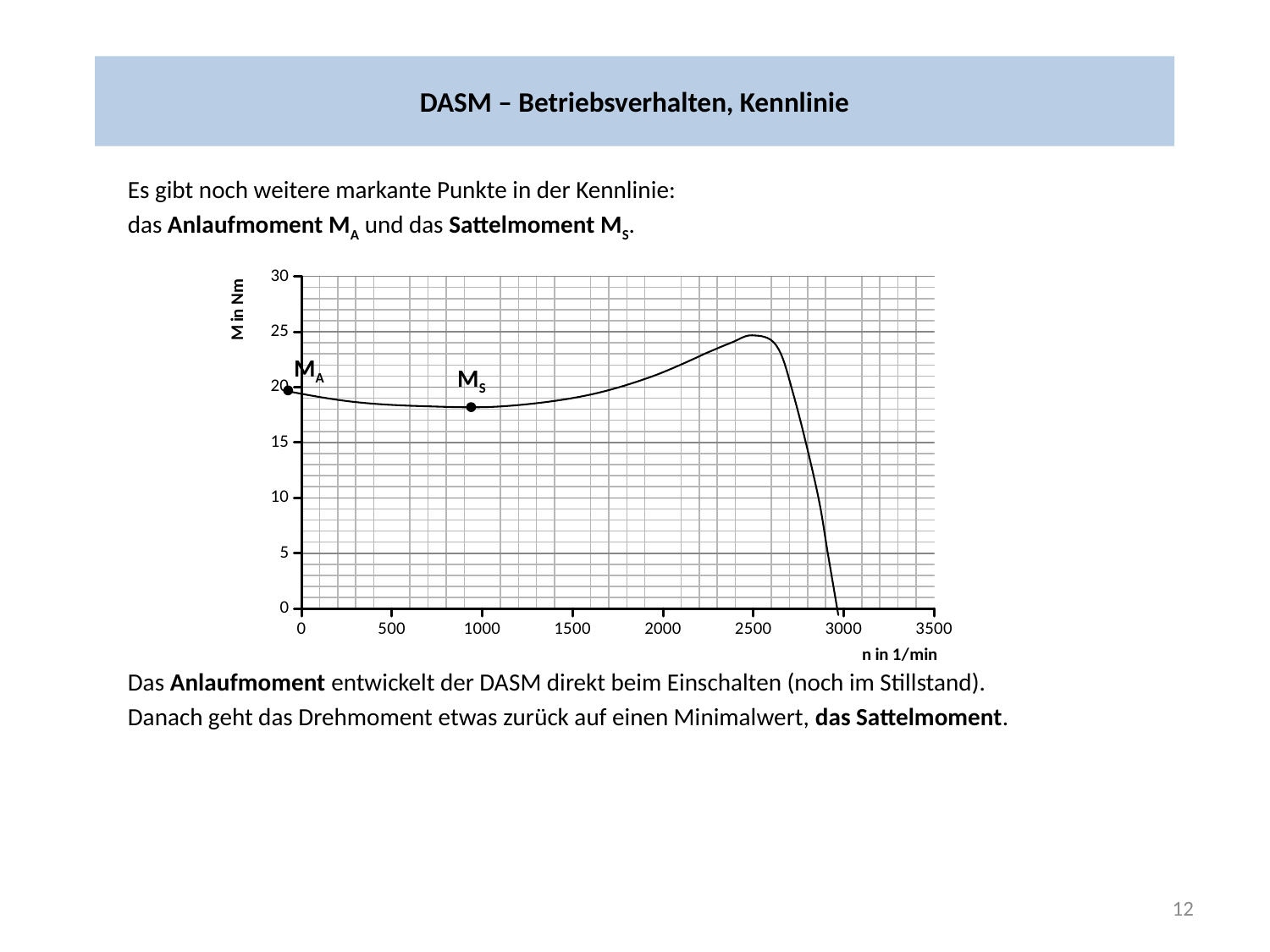
Is the torque value at the point M_S greater or less than 20? less What is the label of the x axis of the chart? n in 1/min What is the label of the y axis of the chart? M in Nm Does the torque rise or fall along the x axis after n = 2500 1/min? fall Is the torque value at the point M_A greater or less than 15? greater Does the torque rise or fall along the x axis between n = 1000 and n = 2500 1/min? rise What kind of chart is shown on the slide? line chart Is the maximum torque of the curve greater or less than 20? greater Which marked point has the higher torque, M_A or M_S? M_A How many marked points are labelled on the curve? 2 Does the torque rise or fall along the x axis between n = 0 and n = 1000 1/min? fall